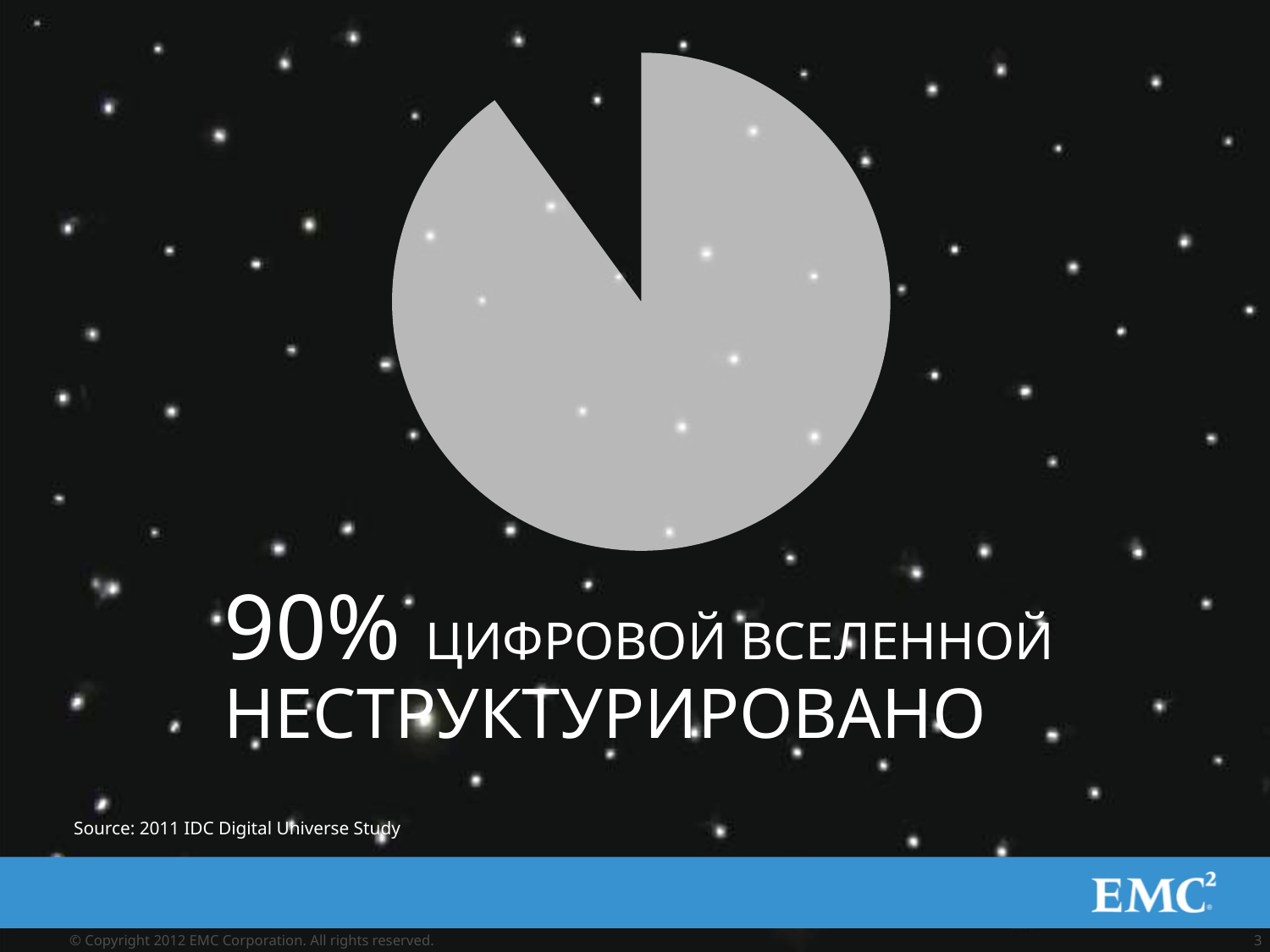
Does the grey slice cover more or less than half of the pie? more What share of the pie is left for the part not covered by the grey slice? 10% What share of the digital universe does the grey slice of the pie chart represent? 90% Is the share shown by the grey slice greater or less than 50%? greater What percentage of the digital universe is stated to be unstructured? 90% What colour is the slice representing the unstructured share of the digital universe? grey What kind of chart is shown on the slide? pie chart What source is cited for the chart's data? 2011 IDC Digital Universe Study